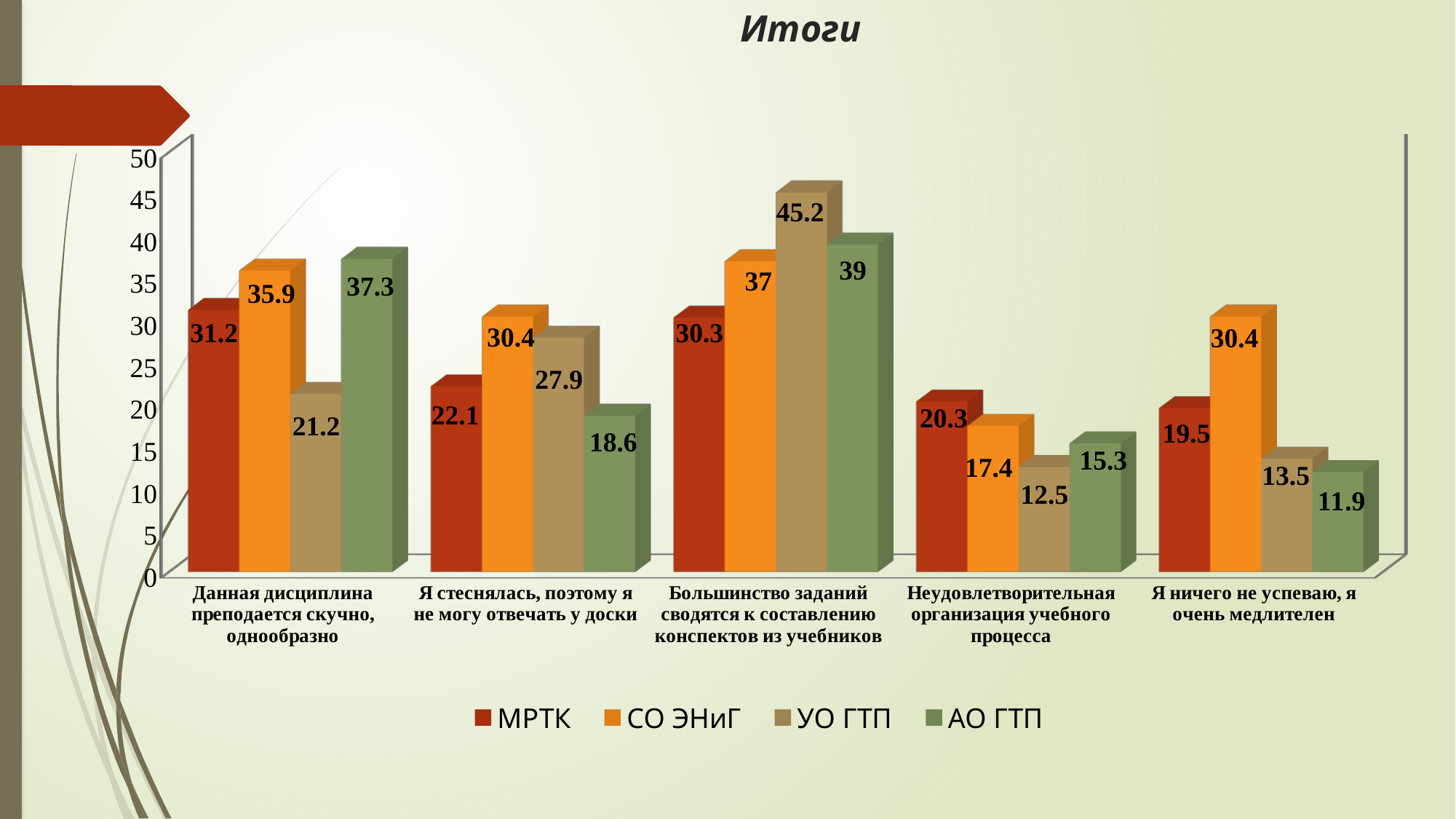
Which series has the highest value in the category "Неудовлетворительная организация учебного процесса"? МРТК What is the value for СО ЭНиГ in the category "Я ничего не успеваю, я очень медлителен"? 30.4 What is the value for АО ГТП in the category "Данная дисциплина преподается скучно, однообразно"? 37.3 Which series has the lowest value in the category "Я стеснялась, поэтому я не могу отвечать у доски"? АО ГТП How many categories are shown on the x axis of the chart? 5 Which series is shown in orange in the legend? СО ЭНиГ What is the value for УО ГТП in the category "Большинство заданий сводятся к составлению конспектов из учебников"? 45.2 What is the title of the slide? Итоги Which is larger in the category "Данная дисциплина преподается скучно, однообразно": the value for МРТК or the value for СО ЭНиГ? СО ЭНиГ How many series does the legend list? 4 What is the difference between the УО ГТП and МРТК values in the category "Большинство заданий сводятся к составлению конспектов из учебников"? 14.9 What kind of chart is shown on the slide? Bar chart